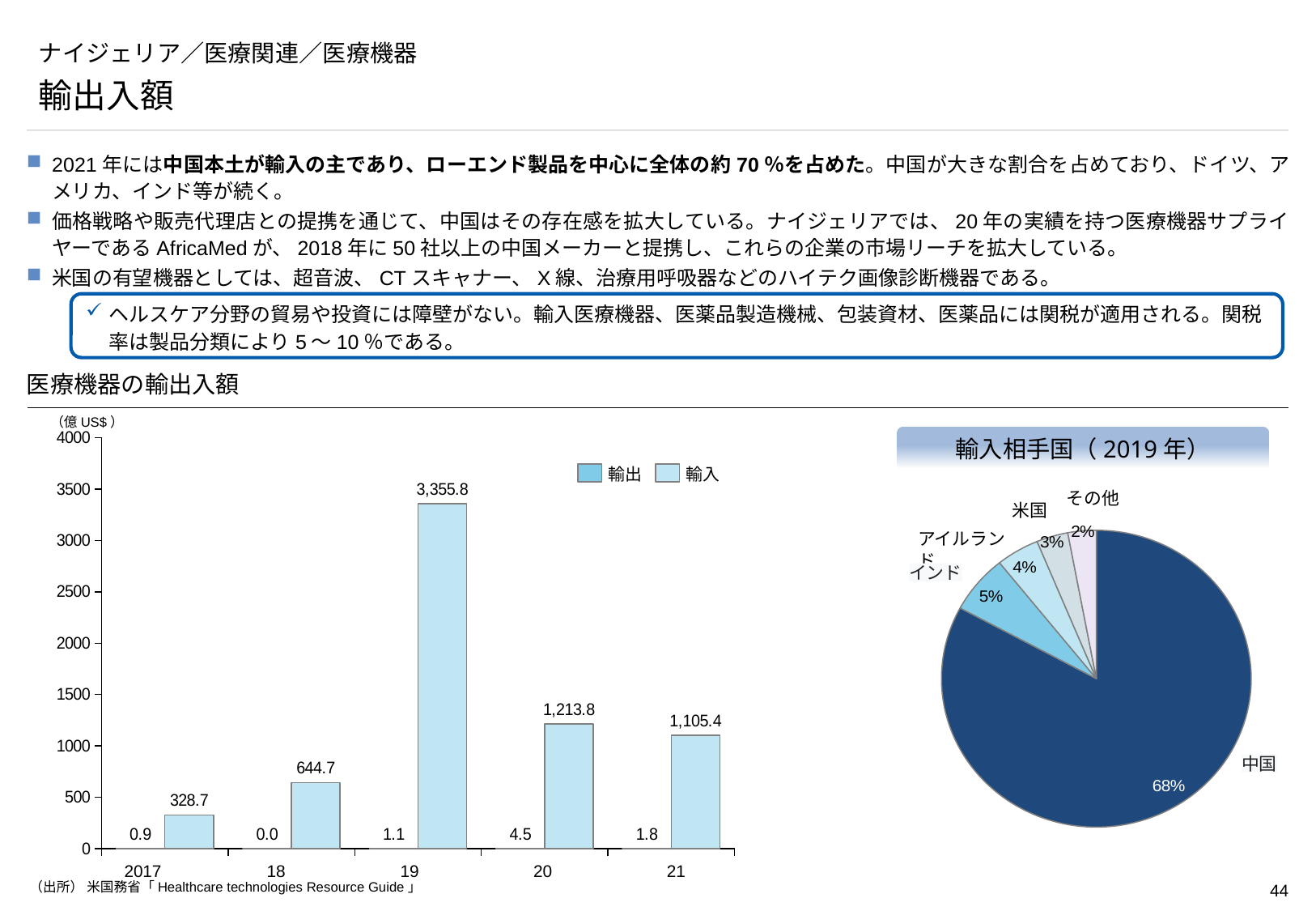
In the pie chart 輸入相手国（2019年）, what share does 米国 have? 3% In the bar chart 医療機器の輸出入額, how many years are shown on the x axis? 5 In the bar chart 医療機器の輸出入額, which year has the highest 輸入 value? 2019 In the bar chart 医療機器の輸出入額, is the 輸入 value for 2018 larger or smaller than the 輸入 value for 2021? smaller What kind of chart is 輸入相手国（2019年）? pie chart In the bar chart 医療機器の輸出入額, which year has the lowest 輸出 value? 2018 In the bar chart 医療機器の輸出入額, what is the 輸入 value for 2017? 328.7 In the bar chart 医療機器の輸出入額, what is the difference between the 輸入 values for 2020 and 2021? 108.4 In the bar chart 医療機器の輸出入額, what is the 輸入 value for 2019? 3,355.8 In the bar chart 医療機器の輸出入額, how many series does the legend list? 2 In the pie chart 輸入相手国（2019年）, what share does 中国 have? 68% In the bar chart 医療機器の輸出入額, what is the 輸出 value for 2020? 4.5